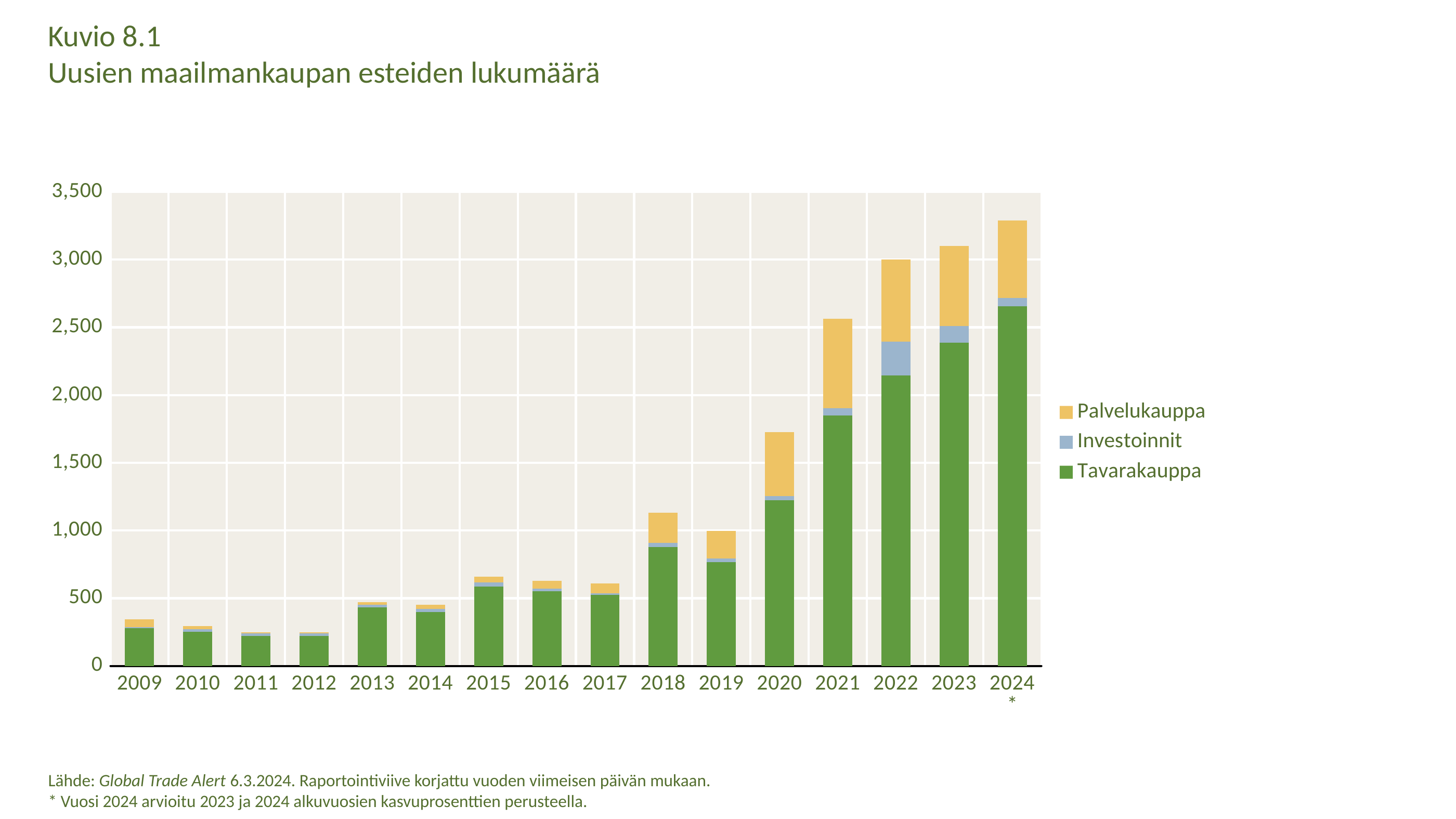
What kind of chart is shown on the slide? stacked bar chart Is the Tavarakauppa value for 2024 greater or less than 2,500? greater Is the total value for 2020 greater or less than 1,500? greater How many series does the legend list? 3 Which series is shown in yellow in the legend? Palvelukauppa Which year has the larger total, 2018 or 2019? 2018 Is the total value for 2009 greater or less than 500? less Do the total values generally rise or fall from 2009 to 2024? rise How many years are shown on the x axis? 16 Which year has the highest total number of new trade barriers? 2024